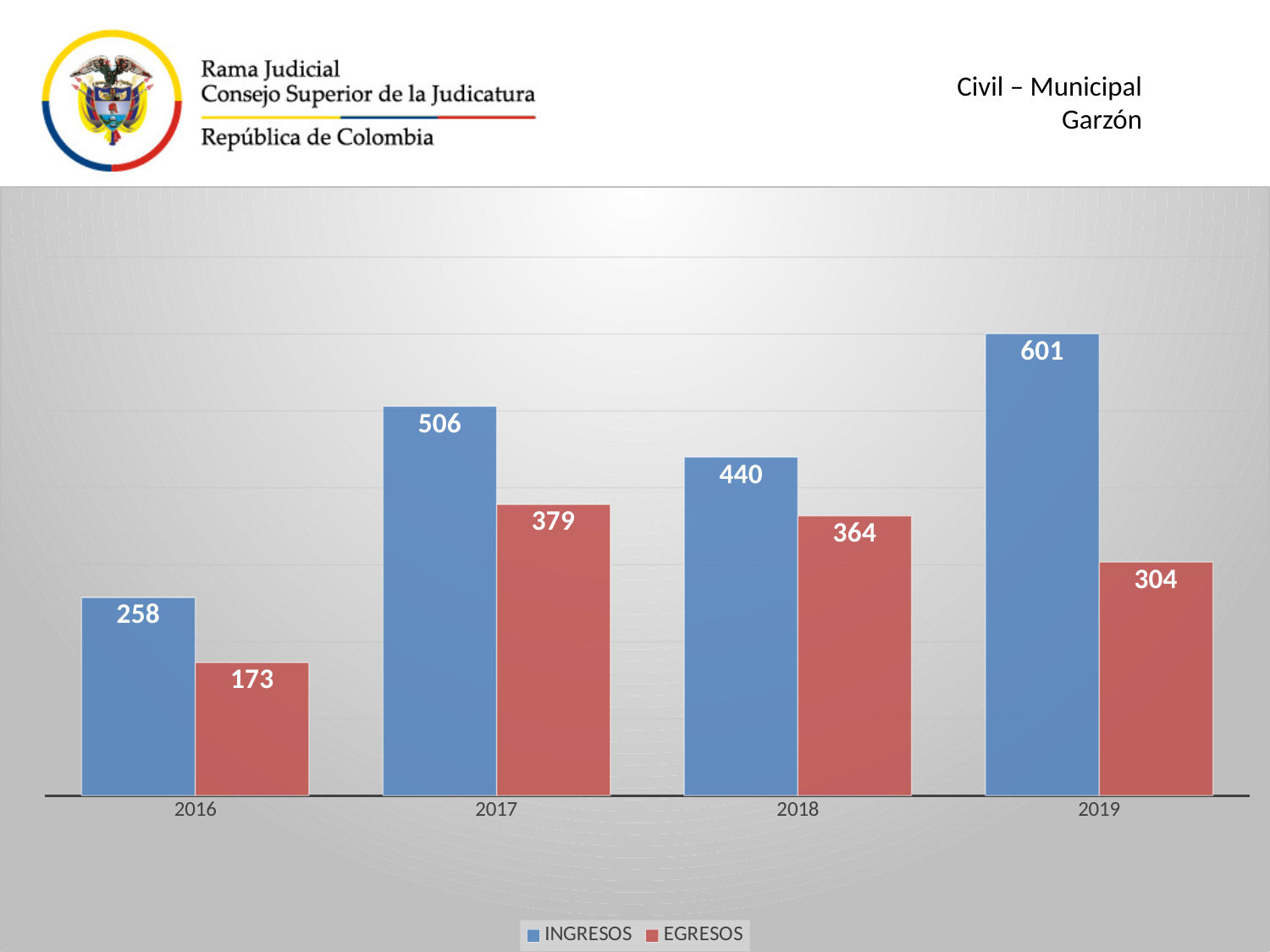
What is the EGRESOS value for 2016? 173 How many series does the legend list? 2 What is the INGRESOS value for 2017? 506 What is the difference between INGRESOS and EGRESOS in 2019? 297 Which series is shown in blue? INGRESOS Which year has the highest INGRESOS value? 2019 What is the difference between the EGRESOS values for 2017 and 2018? 15 What is the EGRESOS value for 2019? 304 Which is larger, INGRESOS in 2018 or EGRESOS in 2017? INGRESOS in 2018 Which year has the lowest EGRESOS value? 2016 How many years are shown on the x axis? 4 What kind of chart is shown on the slide? Bar chart